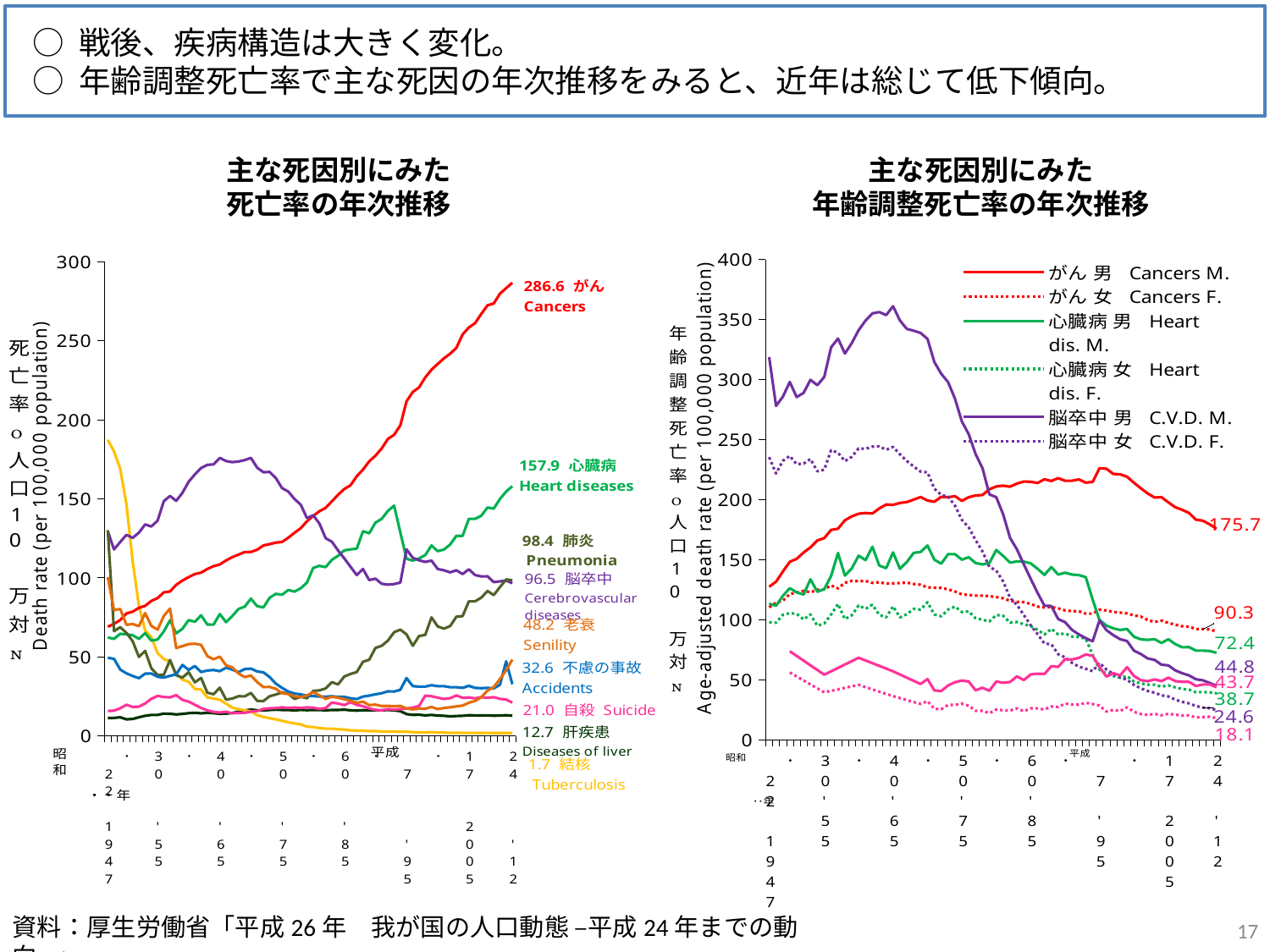
On the left chart (主な死因別にみた死亡率の年次推移), which cause of death has the highest labelled final value? Cancers (がん) On the left chart (主な死因別にみた死亡率の年次推移), what is the final value labelled for Cancers (がん)? 286.6 On the left chart (主な死因別にみた死亡率の年次推移), what is the difference between the final values for Cancers (286.6) and Heart diseases (157.9)? 128.7 What kind of chart is the right chart (主な死因別にみた年齢調整死亡率の年次推移)? line chart On the left chart (主な死因別にみた死亡率の年次推移), which cause of death has the lowest labelled final value? Tuberculosis (結核) On the left chart (主な死因別にみた死亡率の年次推移), what is the final value labelled for Pneumonia (肺炎)? 98.4 On the right chart (主な死因別にみた年齢調整死亡率の年次推移), which is larger at the end of the period: Cancers F. (90.3) or Heart dis. M. (72.4)? Cancers F. (90.3) On the right chart (主な死因別にみた年齢調整死亡率の年次推移), how many series does the legend list? 6 On the left chart (主な死因別にみた死亡率の年次推移), what is the final value labelled for Heart diseases (心臓病)? 157.9 On the right chart (主な死因別にみた年齢調整死亡率の年次推移), what is the final value labelled for Cancers M. (がん 男)? 175.7 On the left chart (主な死因別にみた死亡率の年次推移), does the Cancers (がん) line rise or fall over the period shown? rise On the left chart (主な死因別にみた死亡率の年次推移), what is the final value labelled for Tuberculosis (結核)? 1.7